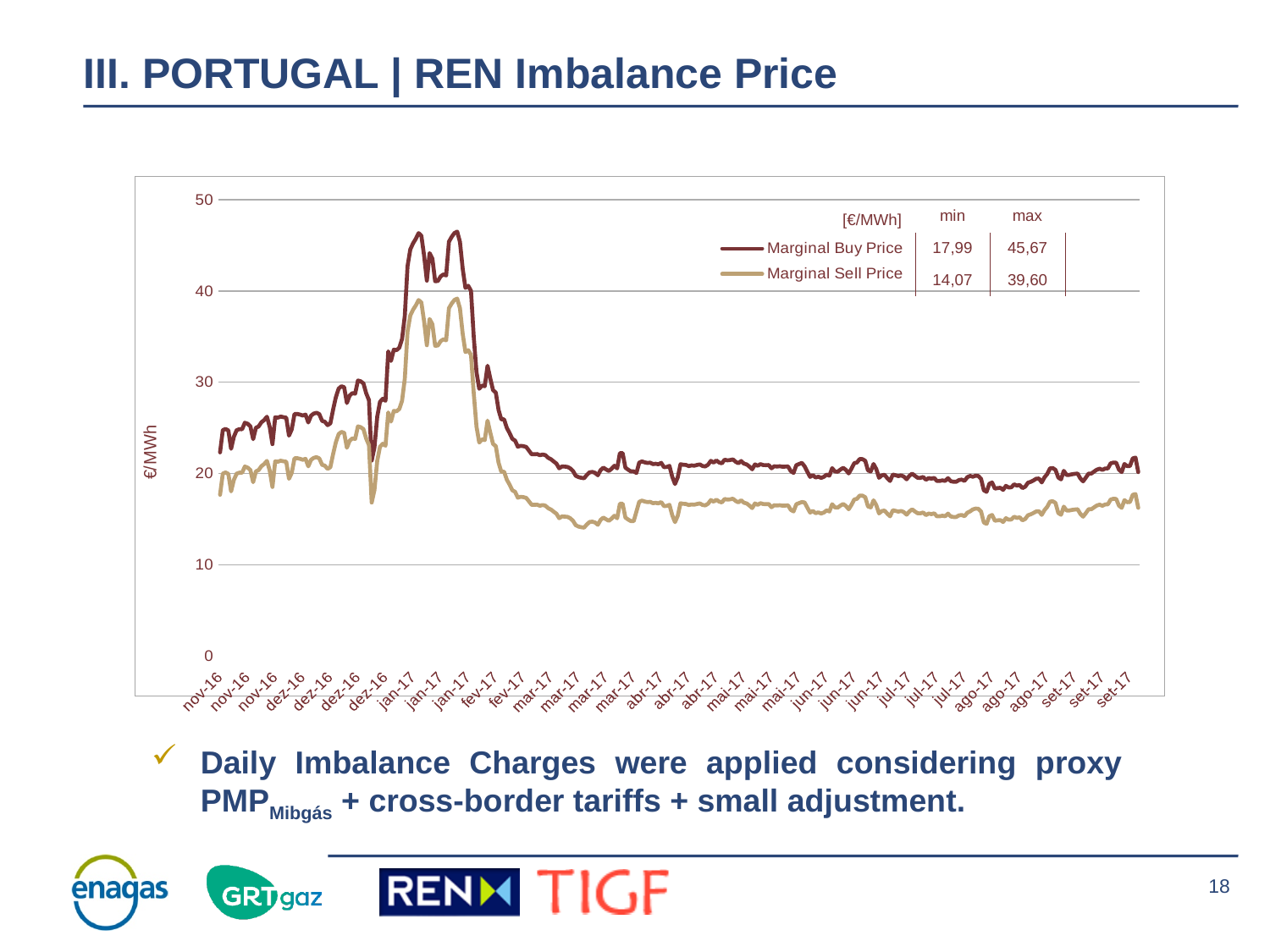
What is the maximum value of the Marginal Sell Price shown in the table? 39,60 What is the minimum value of the Marginal Buy Price shown in the table? 17,99 What kind of chart is shown on the slide? line chart Which series has the higher maximum value, Marginal Buy Price or Marginal Sell Price? Marginal Buy Price What is the difference between the maximum Marginal Buy Price and the maximum Marginal Sell Price? 6,07 Do the prices rise or fall between the jan-17 peak and mar-17? fall What is the minimum value of the Marginal Sell Price shown in the table? 14,07 Is the peak value of the Marginal Buy Price around jan-17 greater or less than 40? greater Is the value of the Marginal Sell Price around mar-17 greater or less than 20? less What unit is shown on the y axis? €/MWh How many series does the legend list? 2 What is the maximum value of the Marginal Buy Price shown in the table? 45,67